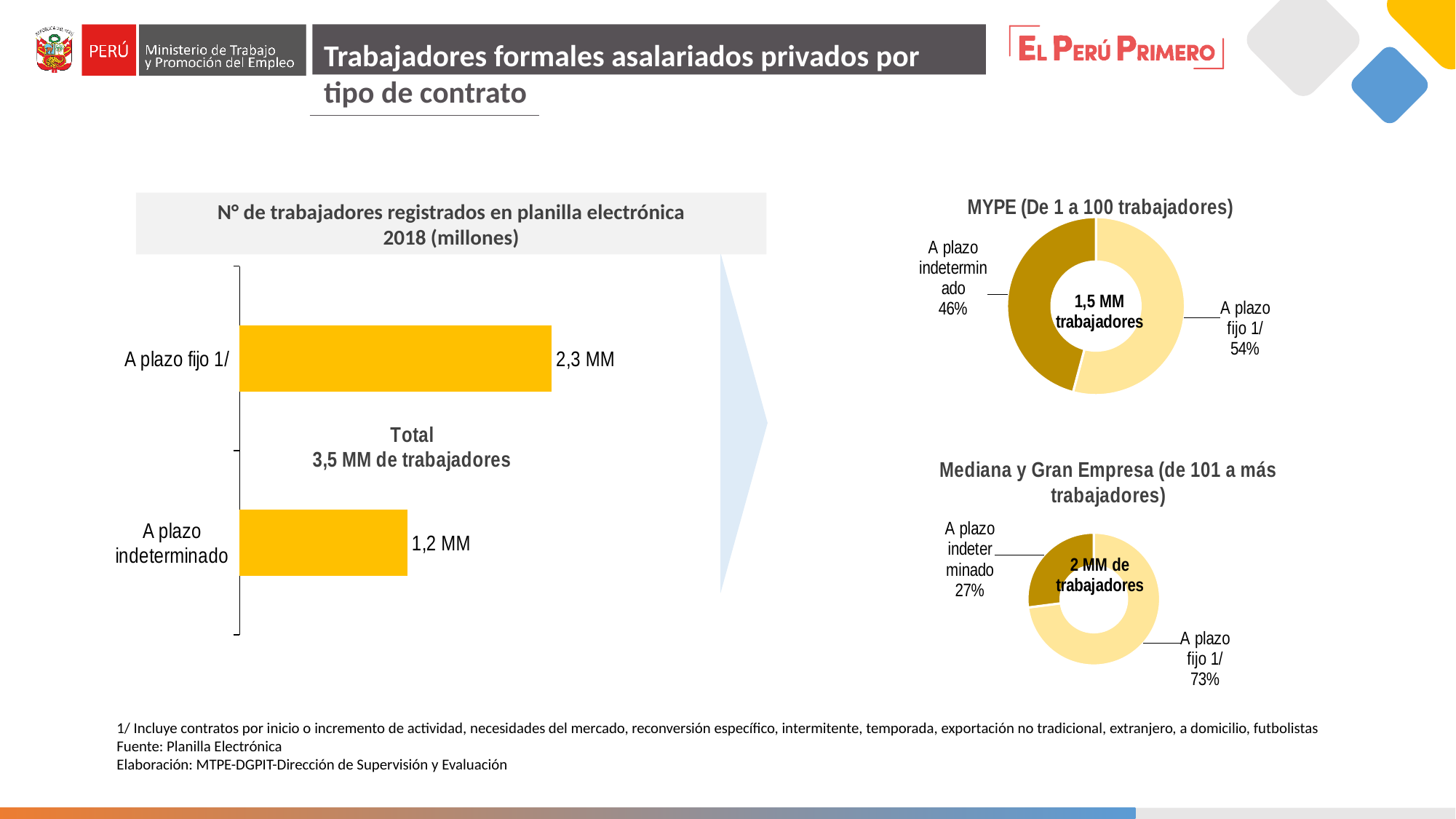
In the bar chart 'N° de trabajadores registrados en planilla electrónica 2018 (millones)', what is the value for 'A plazo indeterminado'? 1,2 MM What kind of chart is the chart on the left of the slide? Bar chart In the bar chart on the left, how many categories are shown? 2 In the 'MYPE (De 1 a 100 trabajadores)' chart, what share is 'A plazo fijo 1/'? 54% In the 'Mediana y Gran Empresa (de 101 a más trabajadores)' chart, which slice is larger, 'A plazo fijo 1/' or 'A plazo indeterminado'? A plazo fijo 1/ What total number of workers is shown in the centre of the 'MYPE (De 1 a 100 trabajadores)' chart? 1,5 MM trabajadores In the 'MYPE (De 1 a 100 trabajadores)' chart, what share is 'A plazo indeterminado'? 46% In the 'Mediana y Gran Empresa (de 101 a más trabajadores)' chart, what share is 'A plazo fijo 1/'? 73% In the bar chart on the left, which category has the lowest value? A plazo indeterminado In the bar chart on the left, what is the difference between 'A plazo fijo 1/' and 'A plazo indeterminado'? 1,1 MM In the bar chart 'N° de trabajadores registrados en planilla electrónica 2018 (millones)', what is the value for 'A plazo fijo 1/'? 2,3 MM In the bar chart on the left, which category has the highest value? A plazo fijo 1/